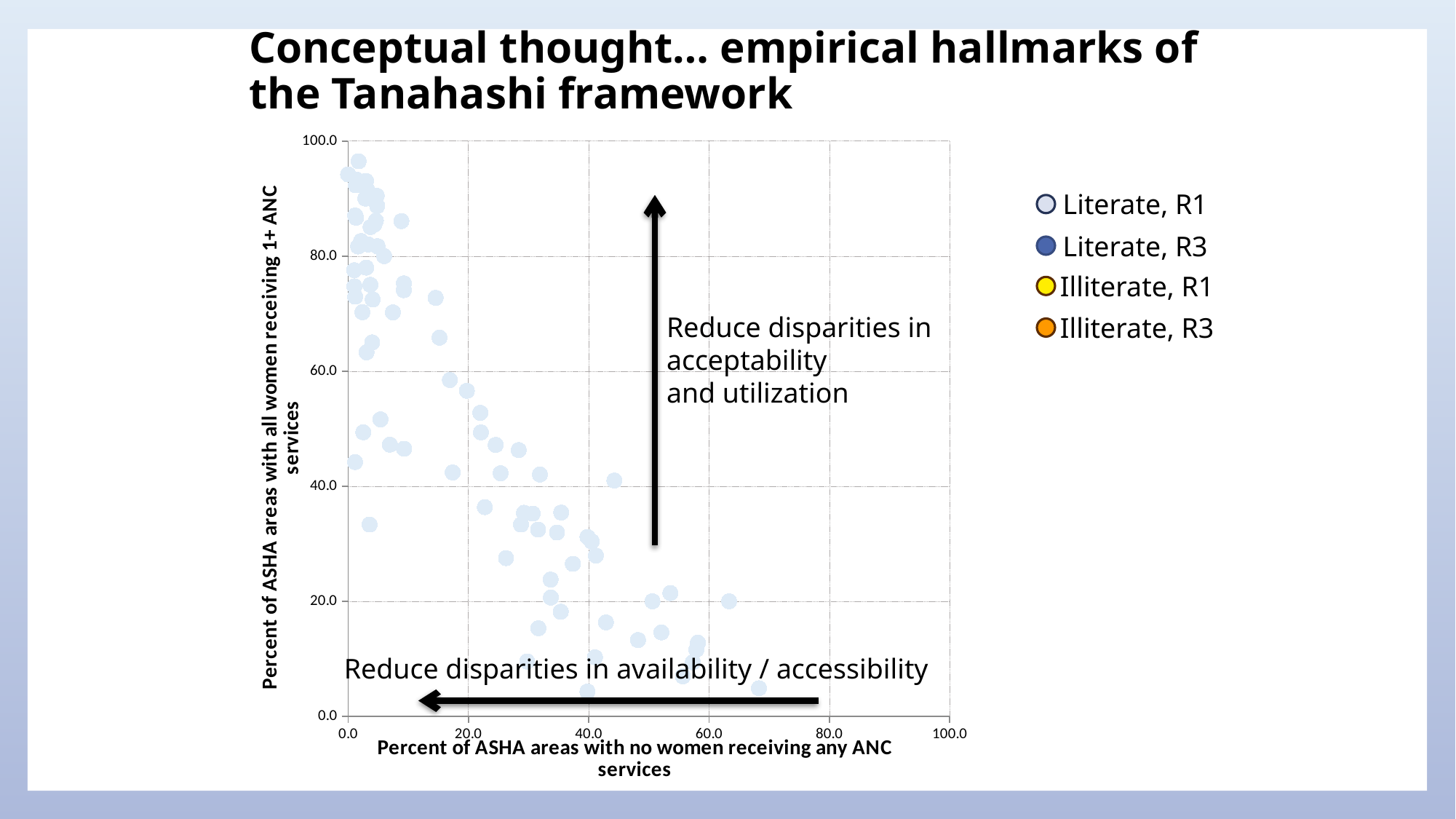
As the x-axis value increases, do the plotted points generally rise or fall? Fall What is the title of the chart's vertical axis? Percent of ASHA areas with all women receiving 1+ ANC services What is the title of the chart's horizontal axis? Percent of ASHA areas with no women receiving any ANC services What is the maximum value shown on the chart's horizontal axis? 100.0 What is the maximum value shown on the chart's vertical axis? 100.0 How many series does the chart's legend list? 4 What is the interval between tick marks on the chart's horizontal axis? 20.0 Are any plotted points located beyond 80.0 on the horizontal axis? No Which legend entry is listed first in the chart? Literate, R1 What kind of chart is shown on the slide? Scatter chart Are any plotted points located above 80.0 on the vertical axis? Yes